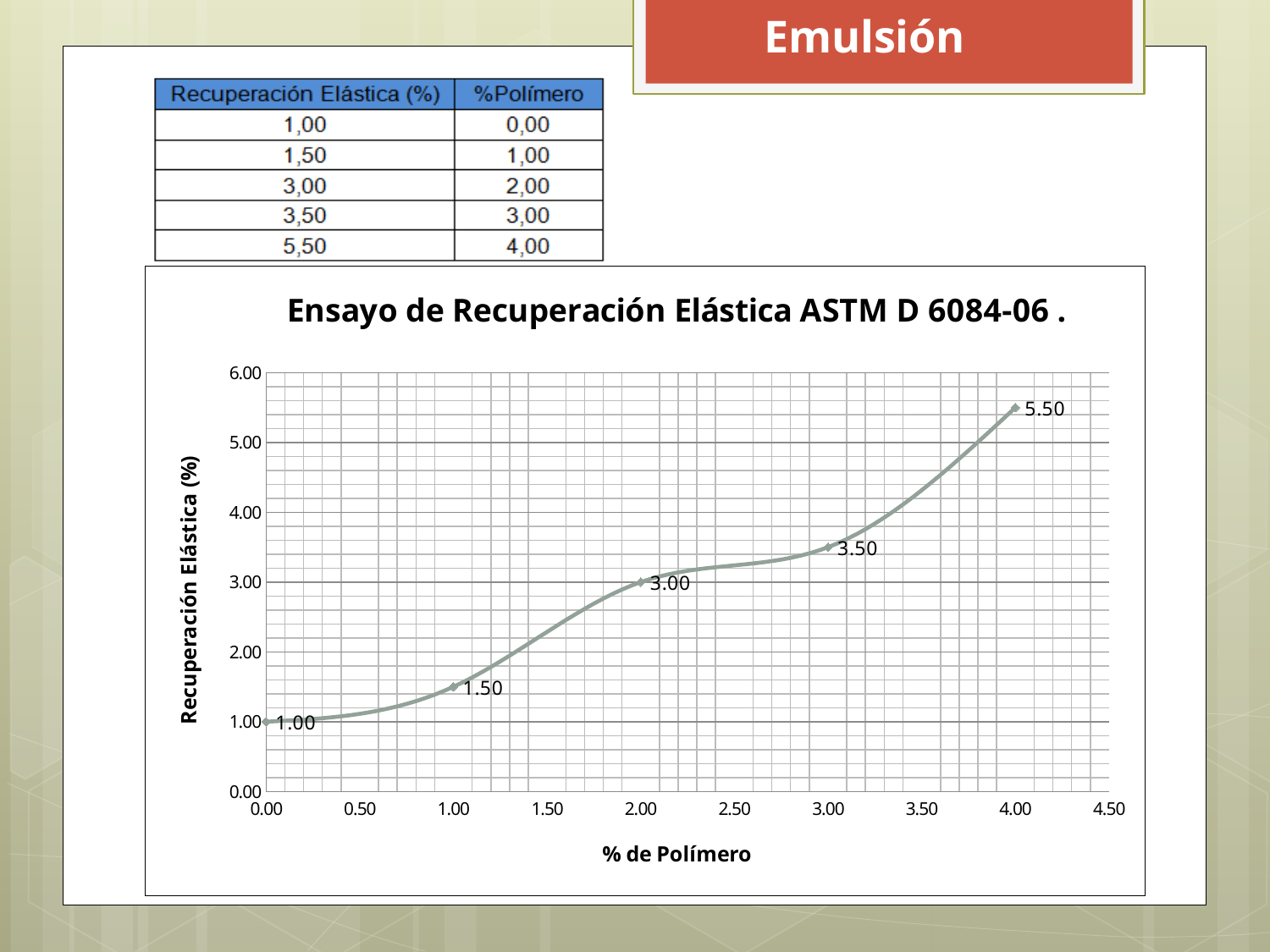
What is the Recuperación Elástica (%) value at 2.00 % de Polímero? 3.00 What kind of chart is shown on the slide? Line chart What is the title of the chart? Ensayo de Recuperación Elástica ASTM D 6084-06 . How many data points are plotted on the chart? 5 Do the Recuperación Elástica values rise or fall as % de Polímero increases? Rise What is the Recuperación Elástica (%) value at 0.00 % de Polímero? 1.00 What is the Recuperación Elástica (%) value at 1.00 % de Polímero? 1.50 At which % de Polímero is the Recuperación Elástica highest? 4.00 What is the difference between the Recuperación Elástica values at 4.00 and 3.00 % de Polímero? 2.00 What is the Recuperación Elástica (%) value at 4.00 % de Polímero? 5.50 At which % de Polímero is the Recuperación Elástica lowest? 0.00 Which is larger, the Recuperación Elástica at 3.00 % de Polímero or at 1.00 % de Polímero? 3.00 % de Polímero